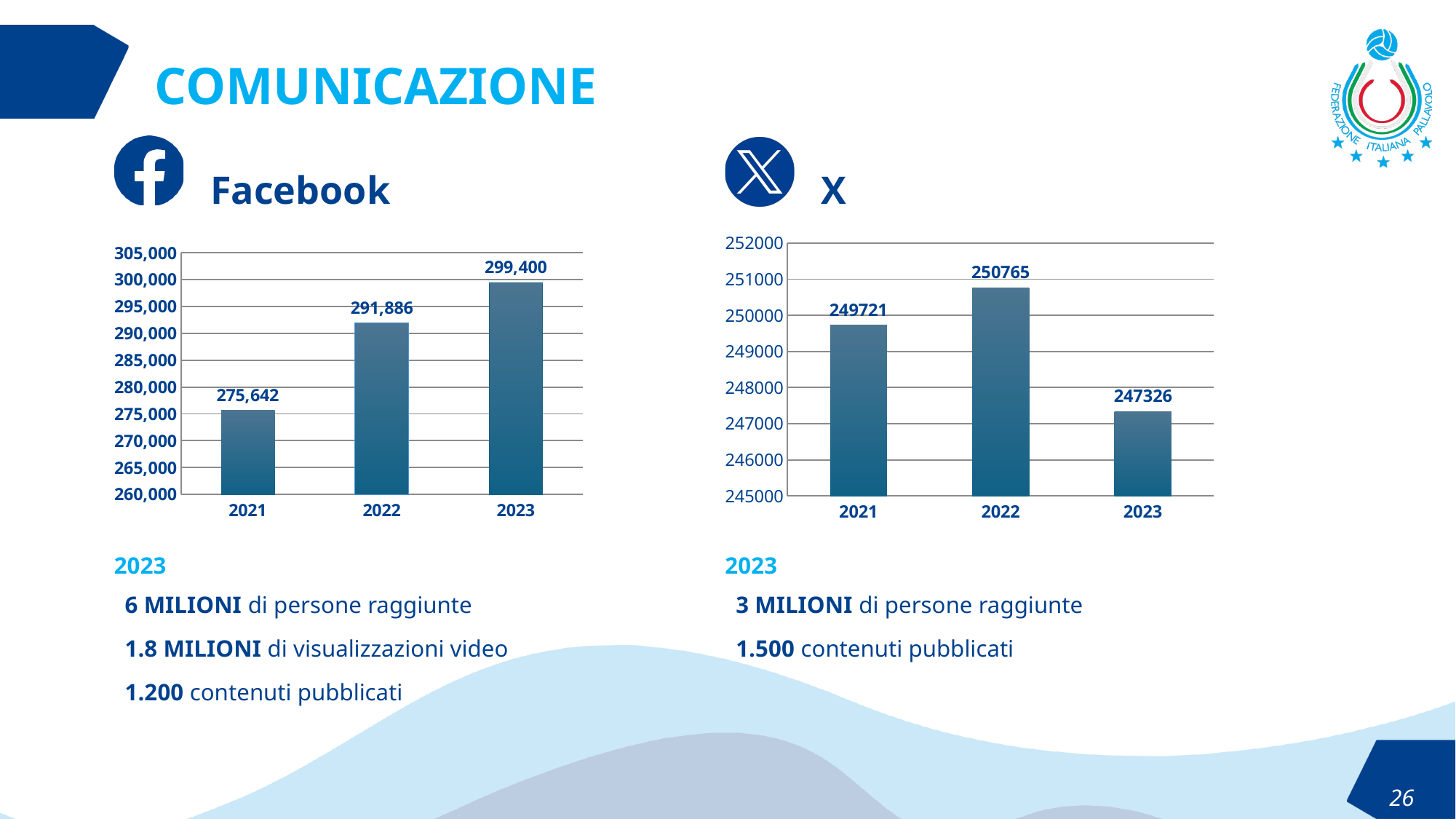
In the X chart, what is the value for 2023? 247326 In the X chart, what is the difference between the 2022 and 2023 values? 3439 What kind of chart is the X chart? bar chart In the X chart, which is larger, the value for 2021 or the value for 2023? 2021 In the X chart, what is the value for 2022? 250765 In the X chart, which year has the lowest value? 2023 In the Facebook chart, which year has the highest value? 2023 In the Facebook chart, what is the value for 2021? 275,642 In the Facebook chart, what is the value for 2023? 299,400 In the Facebook chart, how many years are plotted? 3 In the Facebook chart, do the values rise or fall from 2021 to 2023? rise In the Facebook chart, what is the difference between the 2023 and 2021 values? 23,758